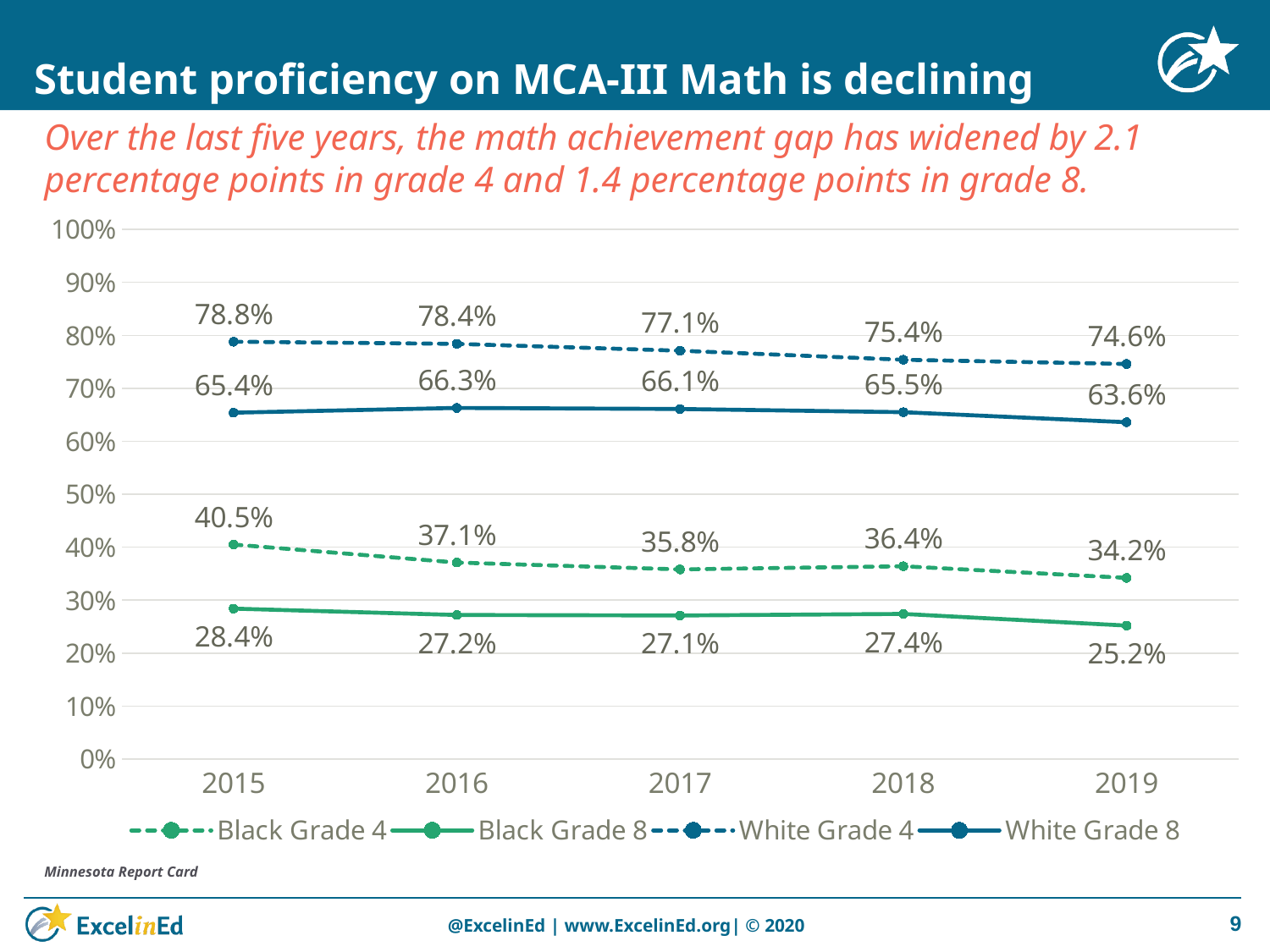
What is the value for Black Grade 8 in 2019? 25.2% What type of chart is shown on the slide? line chart Does the White Grade 4 series rise or fall from 2015 to 2019? fall How many years are shown on the x axis? 5 In which year is the Black Grade 4 value lowest? 2019 Which series is drawn with a solid green line? Black Grade 8 What is the value for White Grade 4 in 2015? 78.8% What is the value for Black Grade 4 in 2017? 35.8% Which is larger in 2018: the White Grade 8 value or the Black Grade 4 value? White Grade 8 What is the difference between the White Grade 4 and Black Grade 4 values in 2019? 40.4 percentage points How many series does the legend list? 4 In which year is the White Grade 8 value highest? 2016